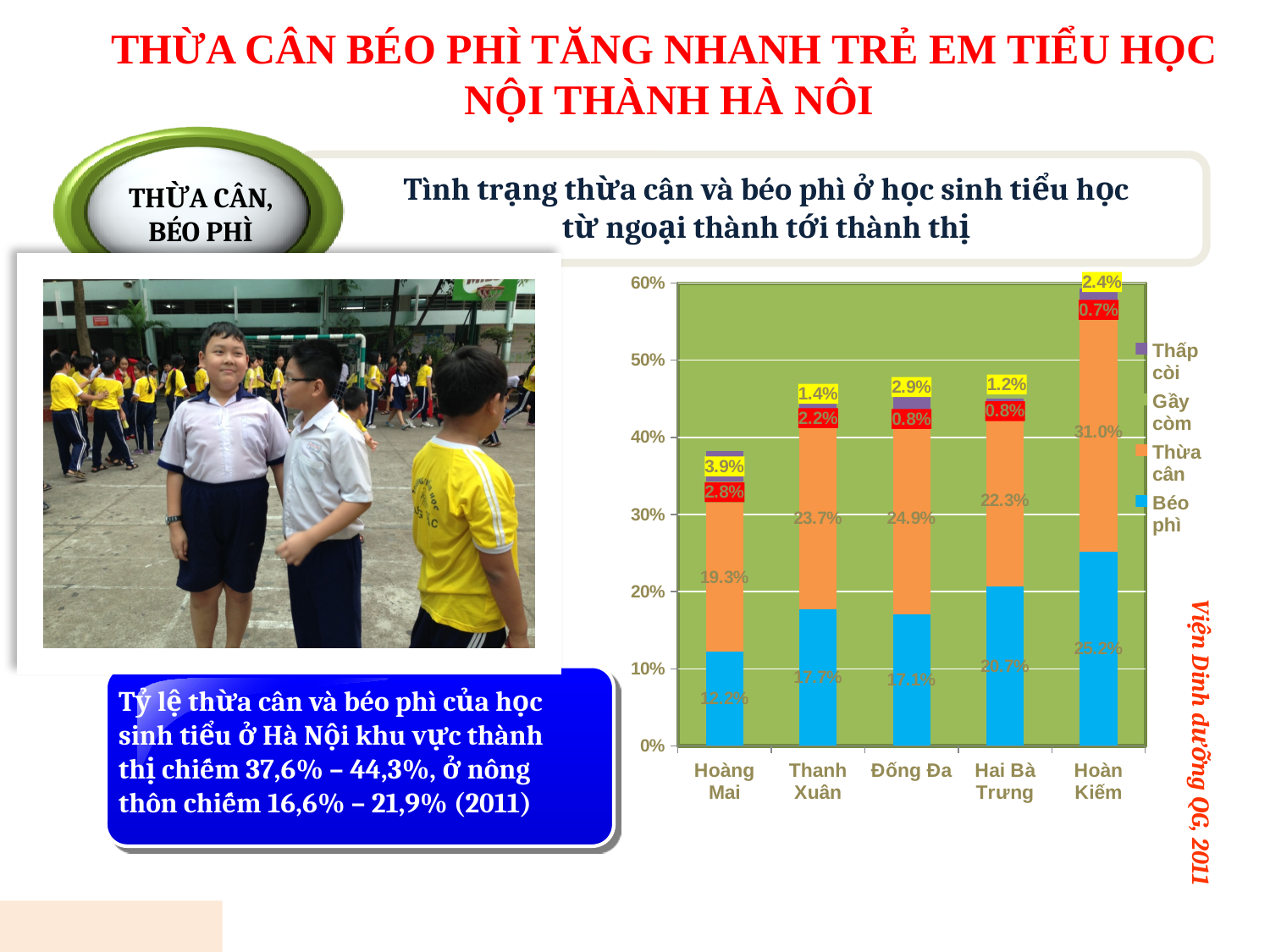
What is the Béo phì value for Hoàng Mai? 12.2% Which district has the lowest Thừa cân value? Hoàng Mai How many districts are shown on the x axis of the chart? 5 What kind of chart is shown on the slide? Stacked bar chart How many series does the chart legend list? 4 Which district has the highest Béo phì value? Hoàn Kiếm Is the total height of the stacked bar for Hoàn Kiếm greater or less than 50%? greater Which is larger, the Béo phì value for Thanh Xuân or for Đống Đa? Thanh Xuân Which district has the tallest stacked bar overall? Hoàn Kiếm What is the difference between the Thừa cân values for Hoàn Kiếm and Hoàng Mai? 11.7% What is the Thừa cân value for Đống Đa? 24.9% What is the Béo phì value for Hoàn Kiếm? 25.2%